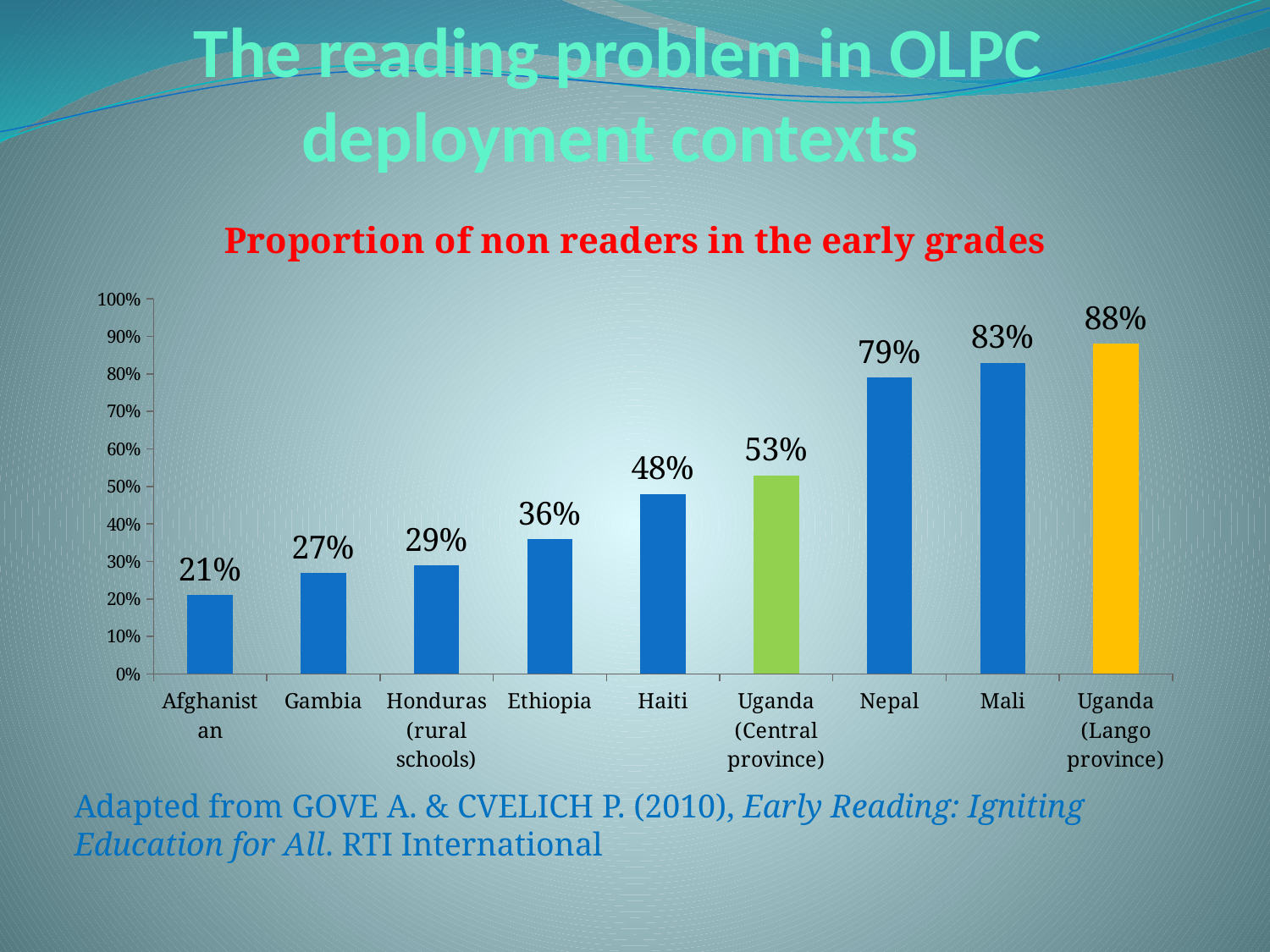
What is the difference between the values for Mali and Nepal? 4% How many countries or regions are shown in the chart? 9 Which category has the highest proportion of non readers? Uganda (Lango province) What is the proportion of non readers for Ethiopia? 36% Do the values rise or fall from left to right along the x axis? Rise What is the proportion of non readers for Haiti? 48% Which category has the lowest proportion of non readers? Afghanistan What kind of chart is shown on the slide? Bar chart What is the proportion of non readers for Uganda (Central province)? 53% Which has a higher proportion of non readers, Gambia or Honduras (rural schools)? Honduras (rural schools) What is the title of the chart? Proportion of non readers in the early grades What is the difference between the values for Uganda (Lango province) and Afghanistan? 67%